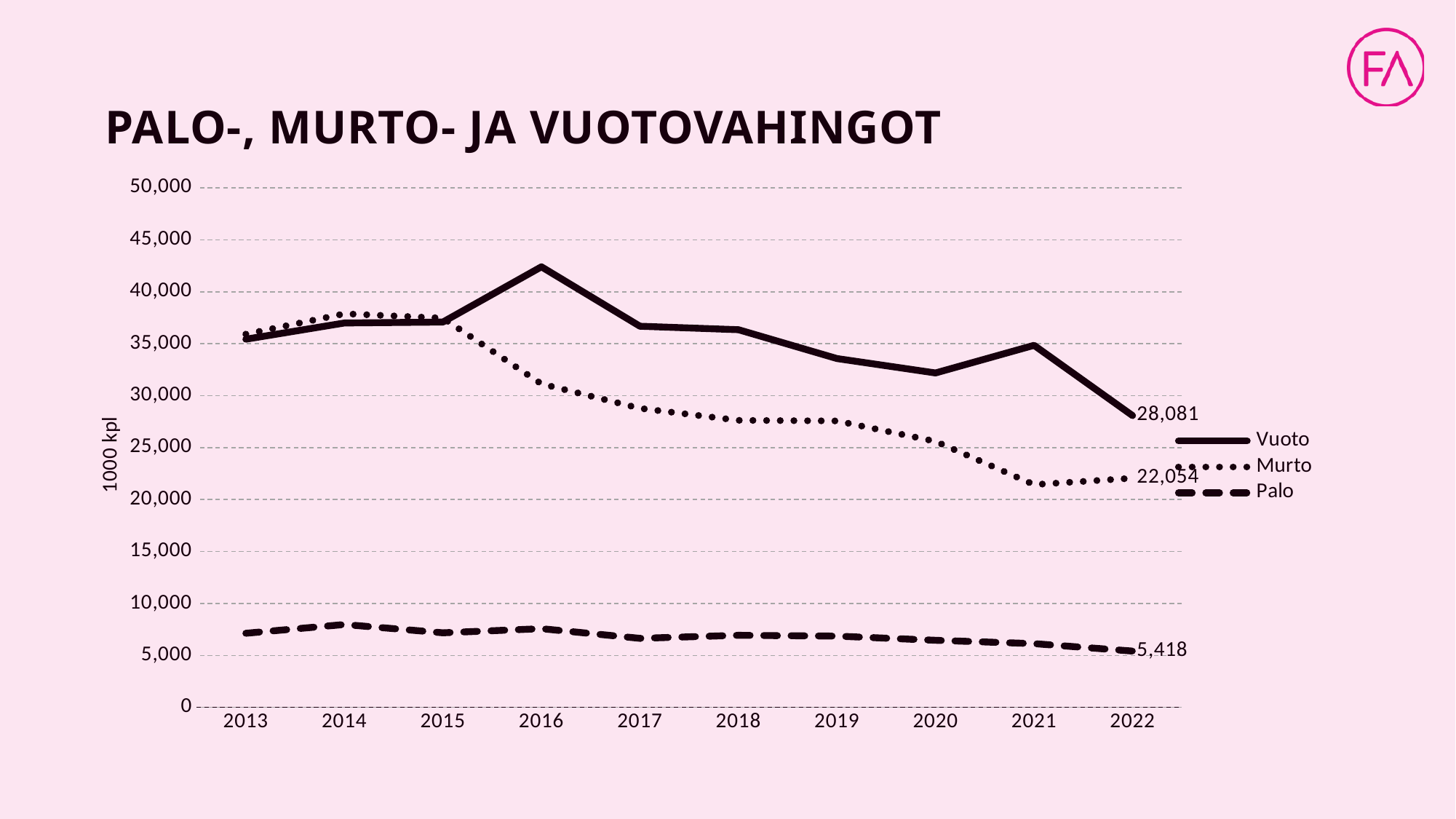
Is the value for Vuoto in 2016 greater or less than 40,000? greater What kind of chart is shown on the slide? line chart Which series has the highest value in 2022? Vuoto What is the value for Murto in 2022? 22,054 Is the value for Palo in 2014 greater or less than 10,000? less Does the Murto series rise or fall from 2015 to 2022? fall What is the value for Palo in 2022? 5,418 How many series does the legend list? 3 What is the difference between the Vuoto and Murto values in 2022? 6,027 How many years are shown on the x axis? 10 What is the difference between the Murto and Palo values in 2022? 16,636 What is the value for Vuoto in 2022? 28,081